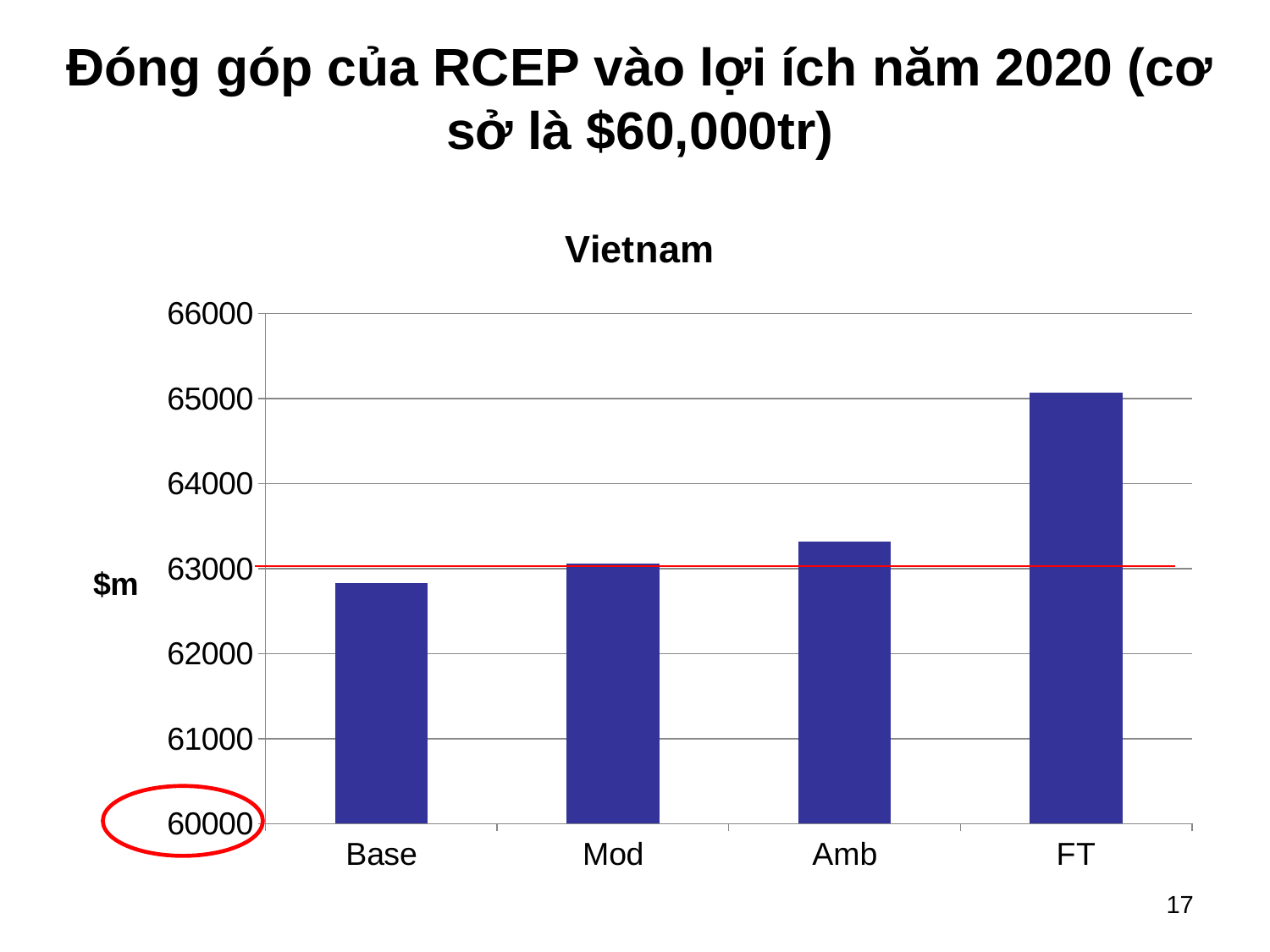
Is the value for Base greater or less than 63000? less How many categories are plotted on the x axis of the Vietnam chart? 4 What kind of chart is shown on the slide? bar chart What is the title of the chart? Vietnam Which category has the highest value in the Vietnam chart? FT Do the values rise or fall moving from Base to FT along the x axis? rise Which is larger, the value for FT or the value for Amb? FT Which is larger, the value for Base or the value for Amb? Amb Is the value for Amb greater or less than 63000? greater Which category has the lowest value in the Vietnam chart? Base Is the value for FT greater or less than 64000? greater